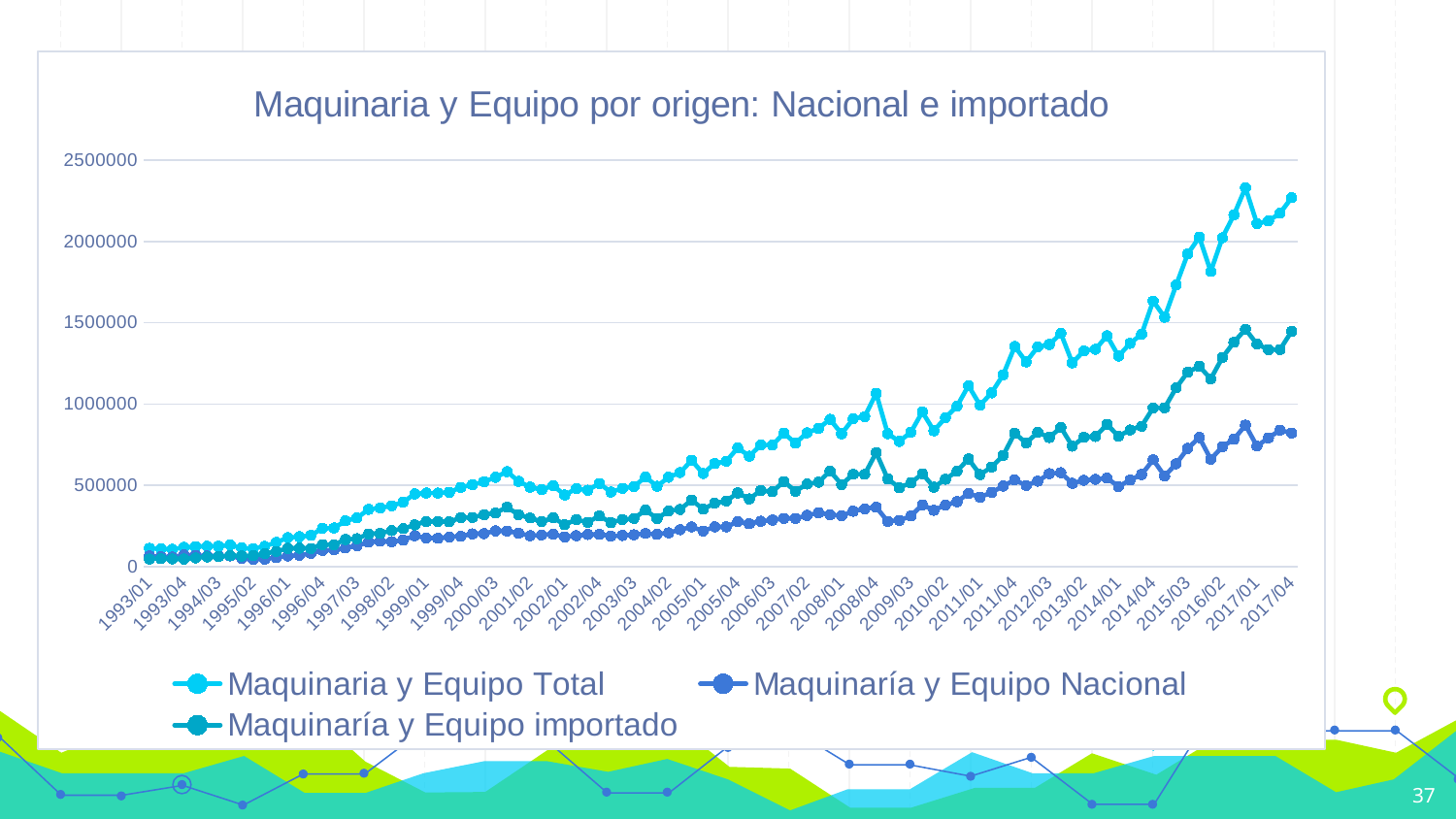
What kind of chart is shown on the slide? line chart How many series does the legend list? 3 What is the title of the chart? Maquinaria y Equipo por origen: Nacional e importado Is the value for Maquinaría y Equipo importado at 2000/03 greater or less than 500000? less Is the value for Maquinaría y Equipo Nacional at 2017/04 greater or less than 1000000? less Overall, do the values of Maquinaria y Equipo Total rise or fall from 1993/01 to 2017/04? rise Which series has the highest values across the chart? Maquinaria y Equipo Total What is the first x-axis label shown on the chart? 1993/01 At 2017/04, which is larger: Maquinaría y Equipo importado or Maquinaría y Equipo Nacional? Maquinaría y Equipo importado Is the value for Maquinaria y Equipo Total at 1993/01 greater or less than 500000? less Which series has the lowest values at 2017/04? Maquinaría y Equipo Nacional